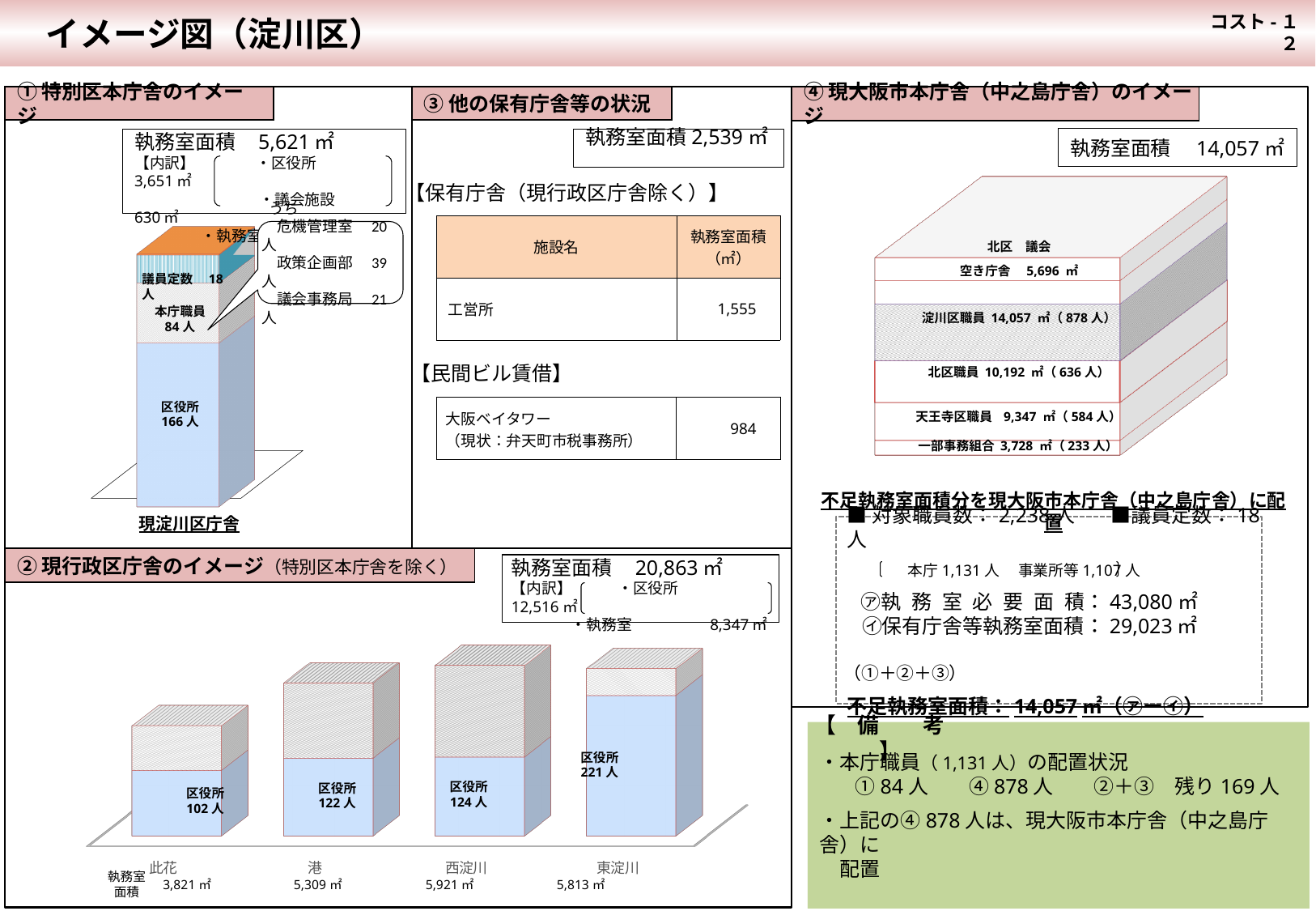
In the ② 現行政区庁舎のイメージ diagram, which ward has the largest 区役所 staff count? 東淀川 In the ② 現行政区庁舎のイメージ diagram, what is the difference in 区役所 staff between 東淀川 and 此花? 119 人 In the ④ 現大阪市本庁舎（中之島庁舎）のイメージ diagram, which block has the largest 執務室面積? 淀川区職員 In the ② 現行政区庁舎のイメージ diagram, which ward has the smallest 執務室面積? 此花 In the ② 現行政区庁舎のイメージ diagram, how many 区役所 staff are shown for 東淀川? 221 人 In the ② 現行政区庁舎のイメージ diagram, what is the 執務室面積 for 此花? 3,821 ㎡ In the ② 現行政区庁舎のイメージ diagram, which has the larger 執務室面積, 港 or 西淀川? 西淀川 In the ④ 現大阪市本庁舎（中之島庁舎）のイメージ diagram, how many staff are shown for 天王寺区職員? 584 人 In the ② 現行政区庁舎のイメージ diagram, how many wards are shown? 4 In the ④ 現大阪市本庁舎（中之島庁舎）のイメージ diagram, what 執務室面積 is shown for 北区職員? 10,192 ㎡ In the ① 特別区本庁舎のイメージ diagram, how many 区役所 staff are shown? 166 人 In the ② 現行政区庁舎のイメージ diagram, what is the 執務室面積 for 西淀川? 5,921 ㎡